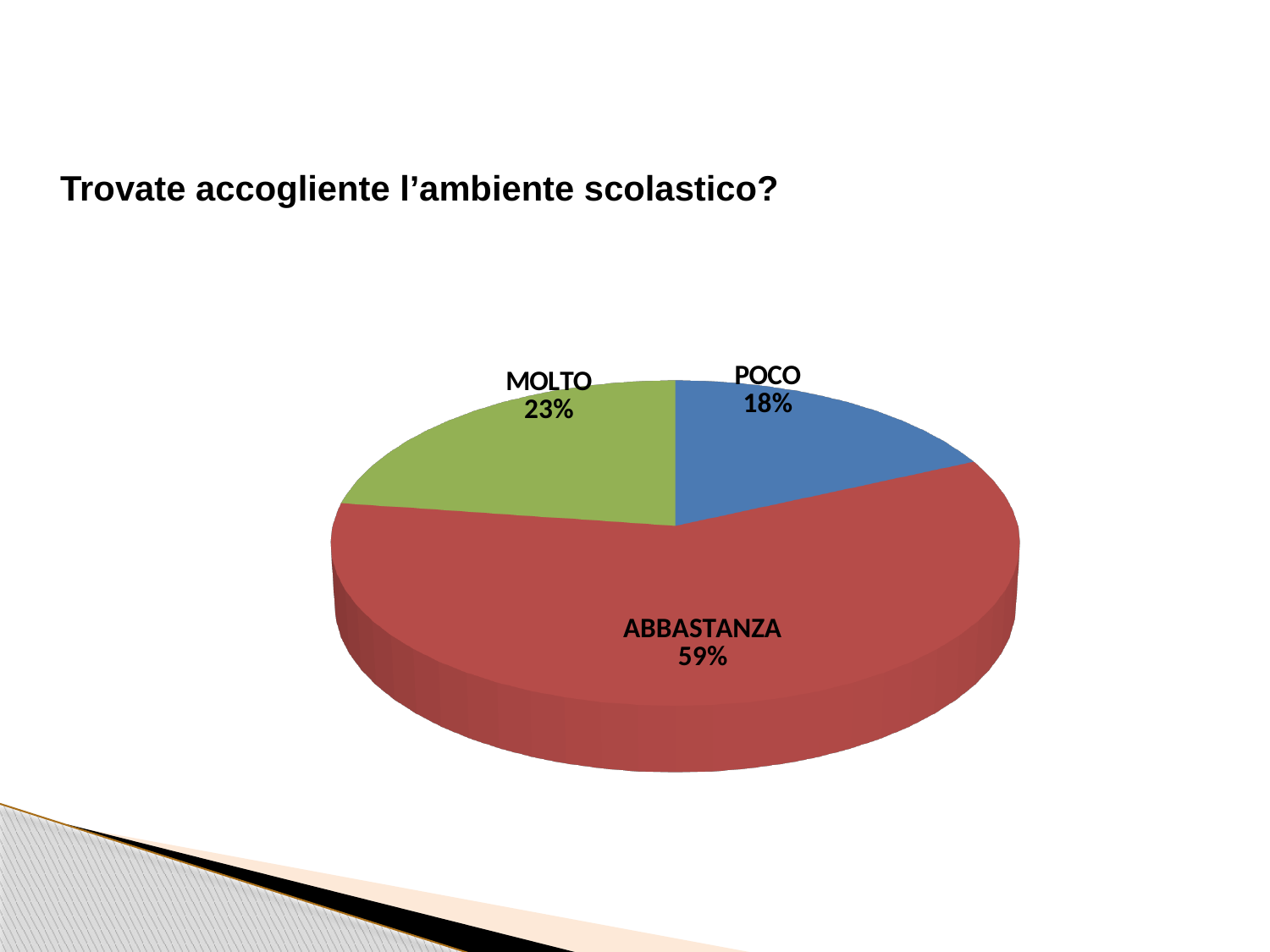
What colour is the ABBASTANZA slice? red What percentage of the pie is labelled MOLTO? 23% Which slice of the pie is the largest? ABBASTANZA What percentage of the pie is labelled ABBASTANZA? 59% How many slices does the pie chart have? 3 What is the difference in percentage points between the ABBASTANZA slice and the MOLTO slice? 36 Which is larger, the MOLTO slice or the POCO slice? MOLTO What question is written as the title above the chart? Trovate accogliente l'ambiente scolastico? What kind of chart is shown on the slide? pie chart Which slice of the pie is the smallest? POCO What is the difference in percentage points between the MOLTO slice and the POCO slice? 5 What percentage of the pie is labelled POCO? 18%